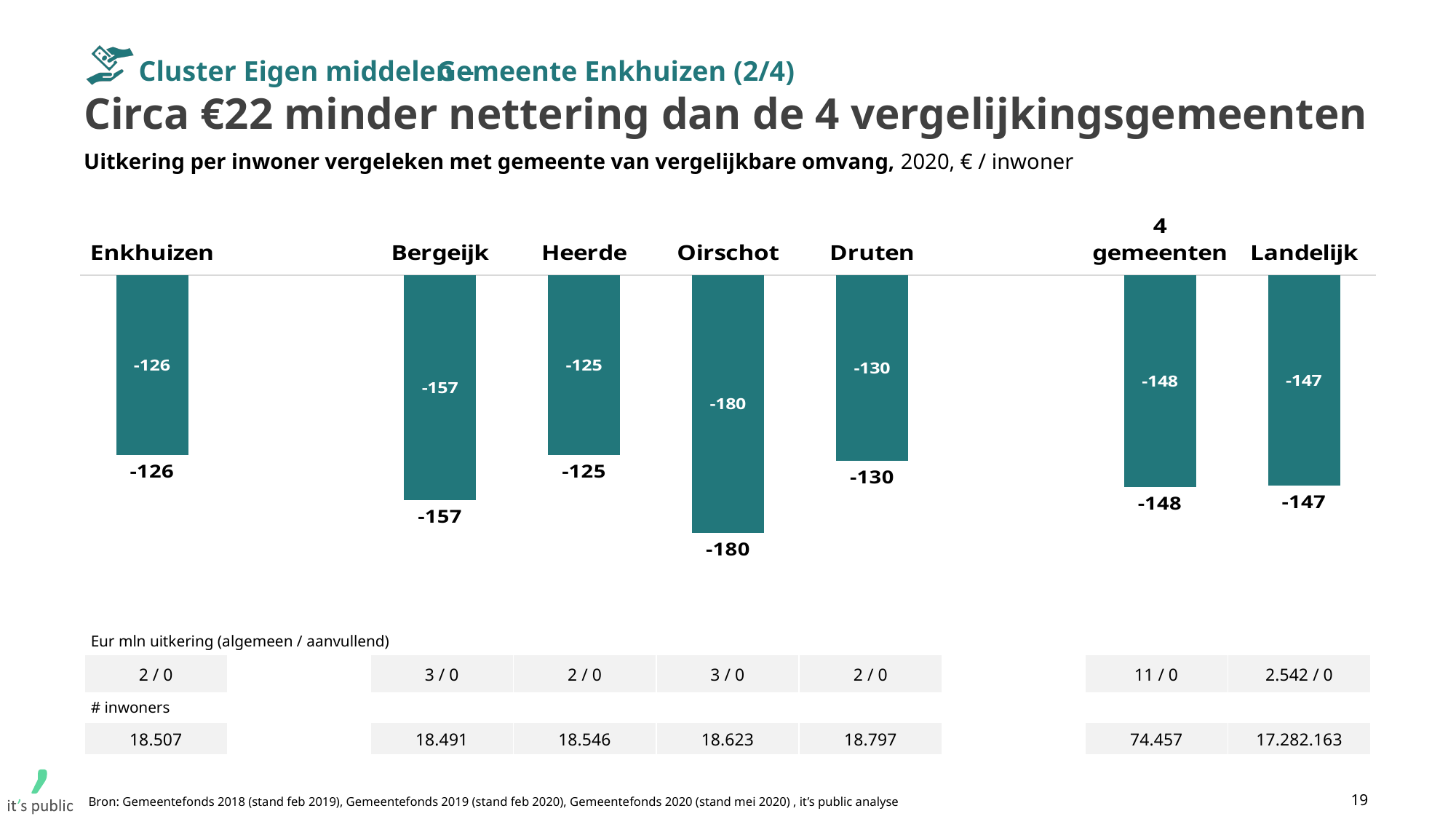
Which category has the lowest (most negative) value? Oirschot What is the difference between the values for Oirschot and Druten? 50 What is the value for Landelijk? -147 In what unit are the chart values expressed, according to the subtitle? € / inwoner What is the value for Enkhuizen? -126 Which category has the highest (least negative) value? Heerde Which has the more negative value, Bergeijk or Druten? Bergeijk What is the value for Oirschot? -180 What is the difference between the values for Enkhuizen and '4 gemeenten'? 22 What is the value for the '4 gemeenten' bar? -148 What type of chart is shown on the slide? Bar chart How many bars are shown in the chart? 7